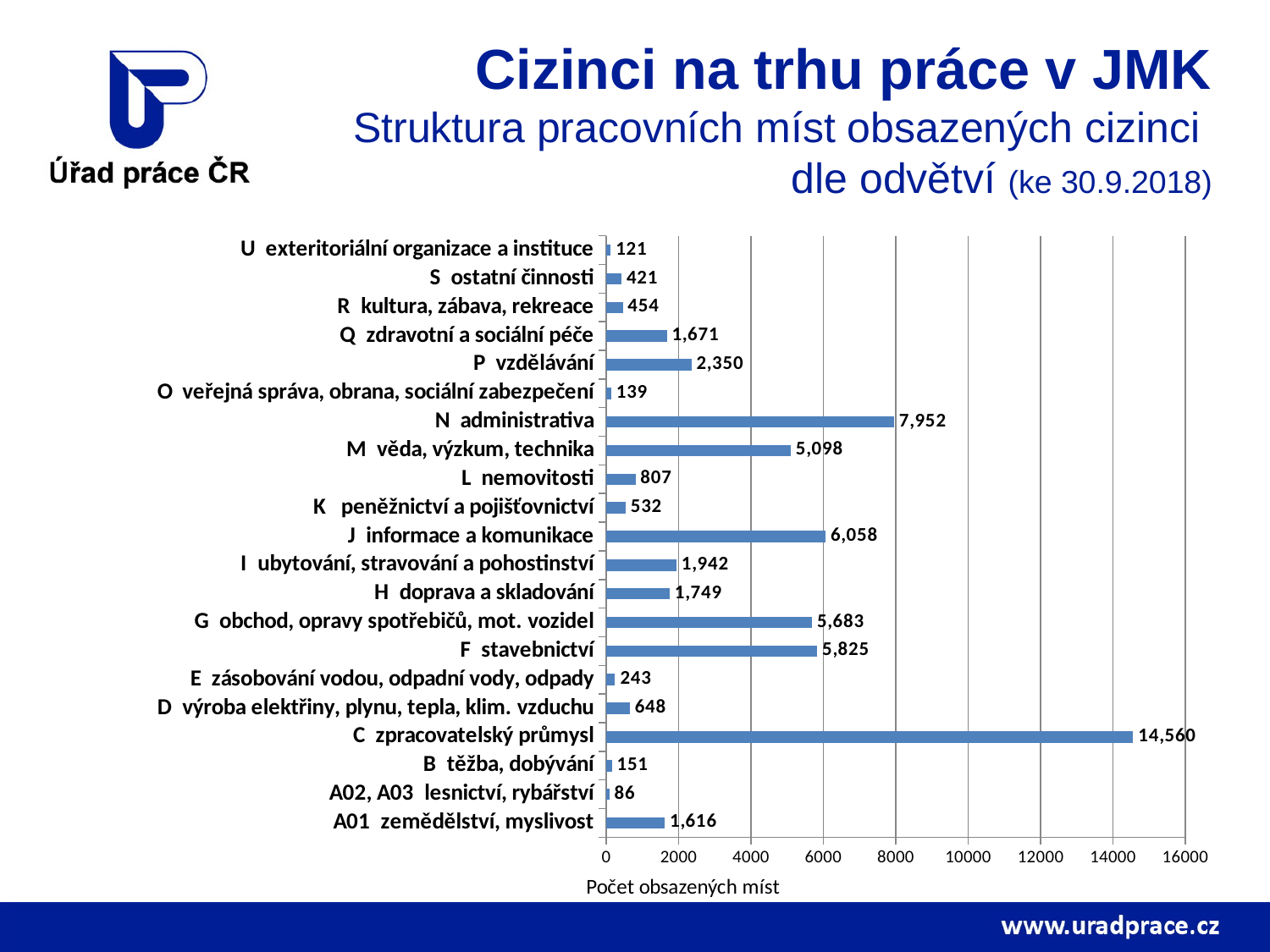
What kind of chart is shown on the slide? bar chart What is the value for C zpracovatelský průmysl? 14,560 Is the value for F stavebnictví greater or less than 4000? greater Which category has the highest value? C zpracovatelský průmysl What is the value for E zásobování vodou, odpadní vody, odpady? 243 What is the value for N administrativa? 7,952 How many categories are shown in the chart? 21 Which is larger, the value for J informace a komunikace or the value for M věda, výzkum, technika? J informace a komunikace What is the difference between the values for N administrativa and M věda, výzkum, technika? 2,854 What is the value for Q zdravotní a sociální péče? 1,671 Which category has the lowest value? A02, A03 lesnictví, rybářství What is the difference between the values for C zpracovatelský průmysl and N administrativa? 6,608